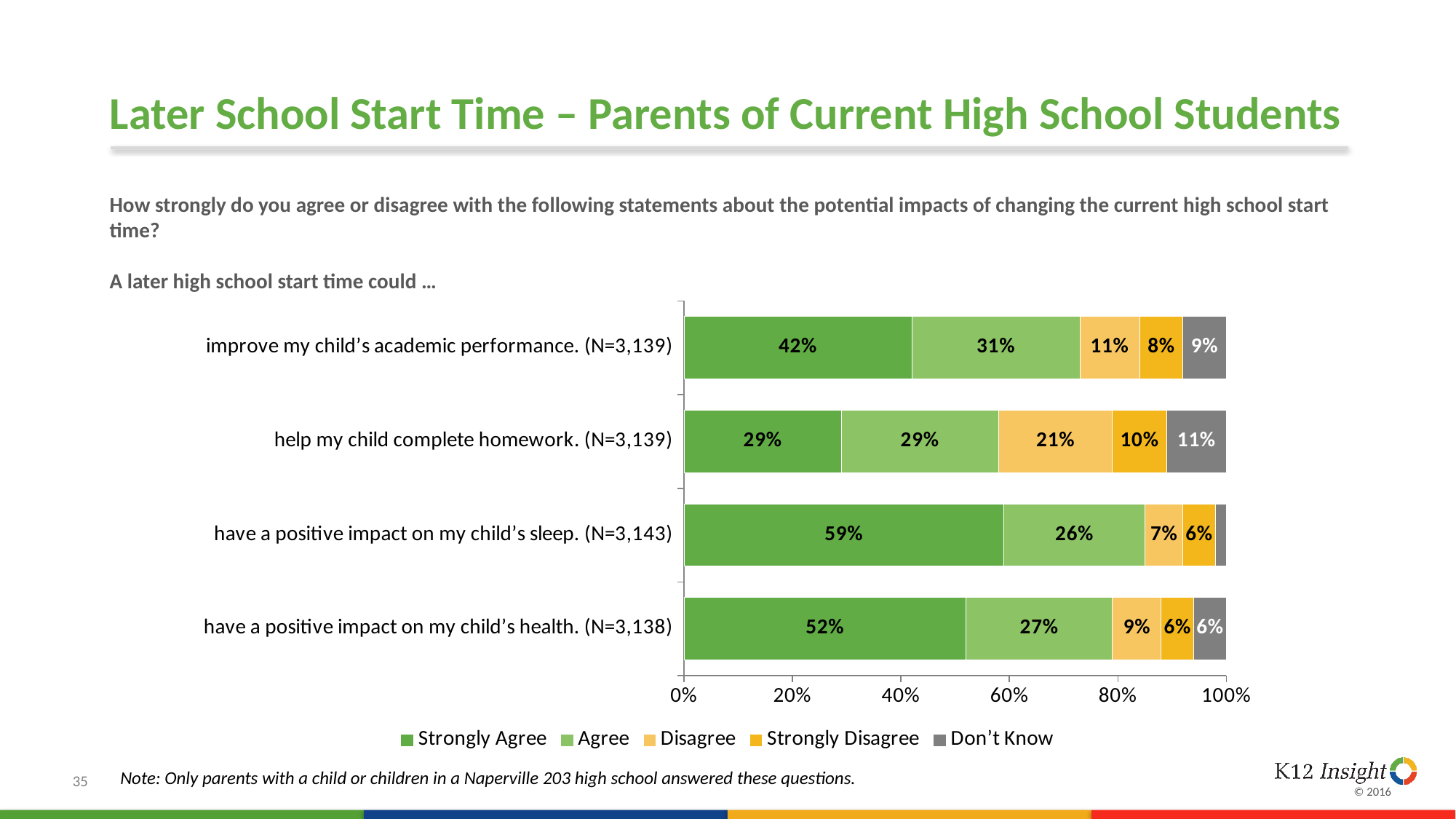
Which response category is shown in dark green in the legend? Strongly Agree What percentage of parents disagree that a later start time could help their child complete homework? 21% Which statement has the lowest Strongly Agree percentage? help my child complete homework Which has a larger Agree percentage: 'improve my child's academic performance' or 'have a positive impact on my child's health'? improve my child's academic performance What type of chart is shown on the slide? Stacked bar chart How many percentage points higher is Strongly Agree for 'improve my child's academic performance' than for 'help my child complete homework'? 13 percentage points What is the combined Strongly Agree and Agree percentage for 'have a positive impact on my child's health'? 79% What is the Don't Know percentage for the statement 'help my child complete homework'? 11% Which statement has the highest Strongly Agree percentage? have a positive impact on my child's sleep What percentage of parents strongly agree that a later start time could have a positive impact on their child's sleep? 59% How many statements are shown in the chart? 4 How many response categories does the legend list? 5